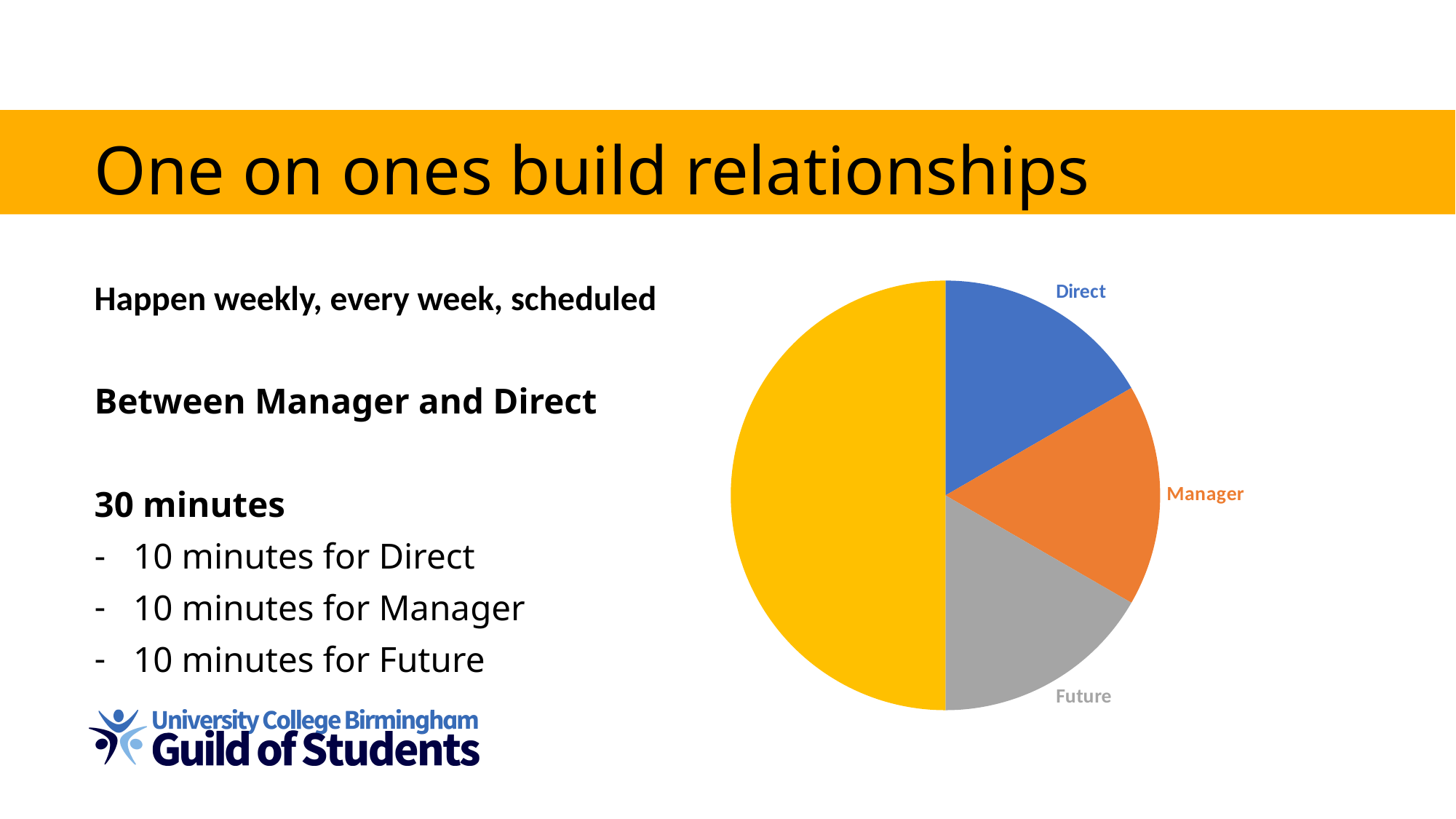
How many slices of the pie chart have a label? 3 What colour is the Future slice of the pie chart? grey Which is larger, the unlabelled yellow slice or the Manager slice? the yellow slice Which is larger, the unlabelled yellow slice or the Direct slice? the yellow slice What kind of chart is shown on the slide? pie chart What colour is the Direct slice of the pie chart? blue